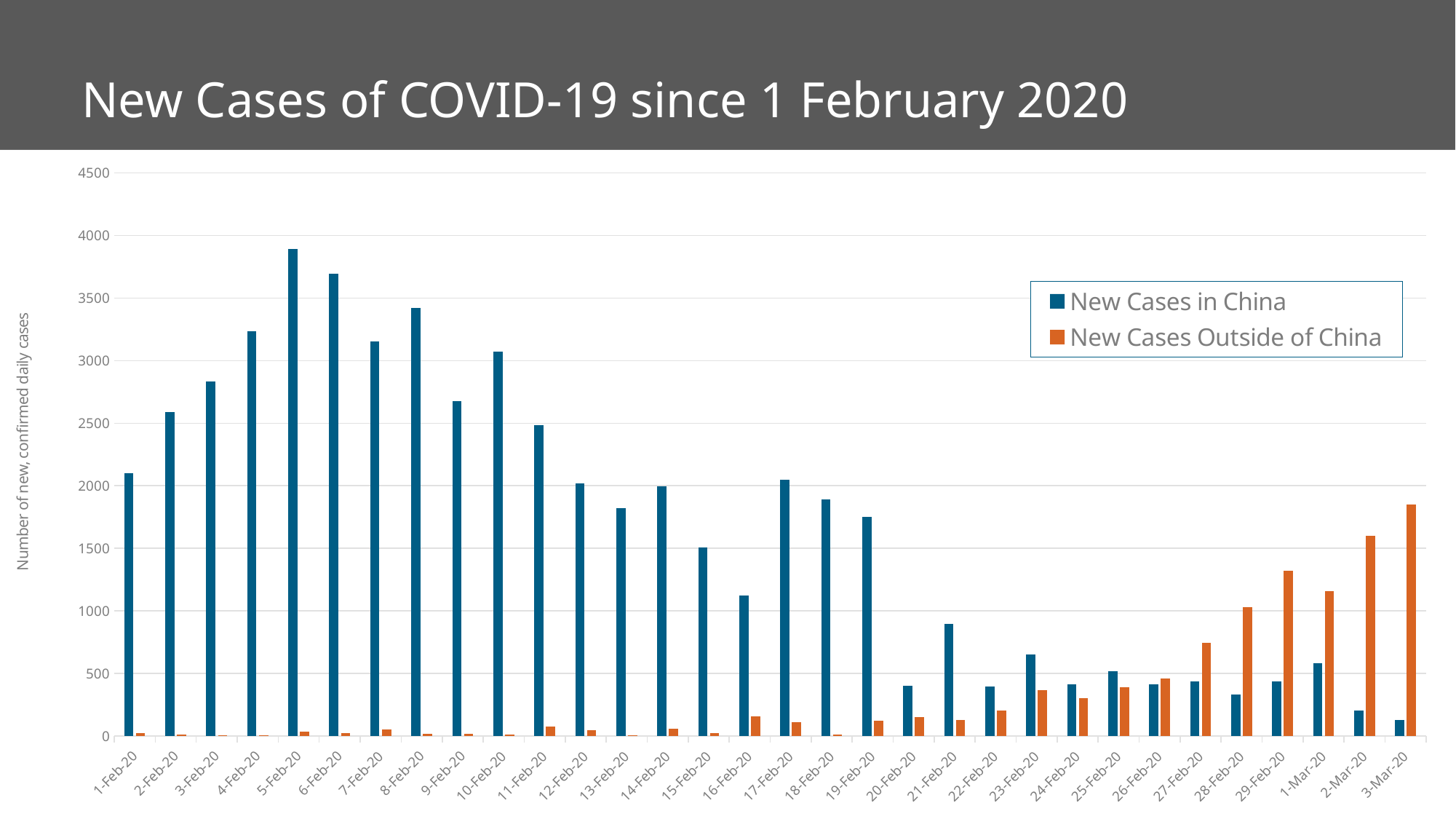
Is the value for New Cases in China on 6-Feb-20 greater or less than 3500? greater On which date is the value for New Cases in China lowest? 3-Mar-20 How many series does the legend list? 2 Is the value for New Cases Outside of China on 29-Feb-20 greater or less than 1000? greater Is the value for New Cases in China on 20-Feb-20 greater or less than 500? less How many dates are shown along the x axis? 32 On which date is the value for New Cases in China highest? 5-Feb-20 On 3-Mar-20, which is larger: New Cases in China or New Cases Outside of China? New Cases Outside of China Do the values for New Cases Outside of China generally rise or fall from 22-Feb-20 to 3-Mar-20? rise What kind of chart is shown on the slide? bar chart On which date is the value for New Cases Outside of China highest? 3-Mar-20 On 1-Feb-20, which is larger: New Cases in China or New Cases Outside of China? New Cases in China